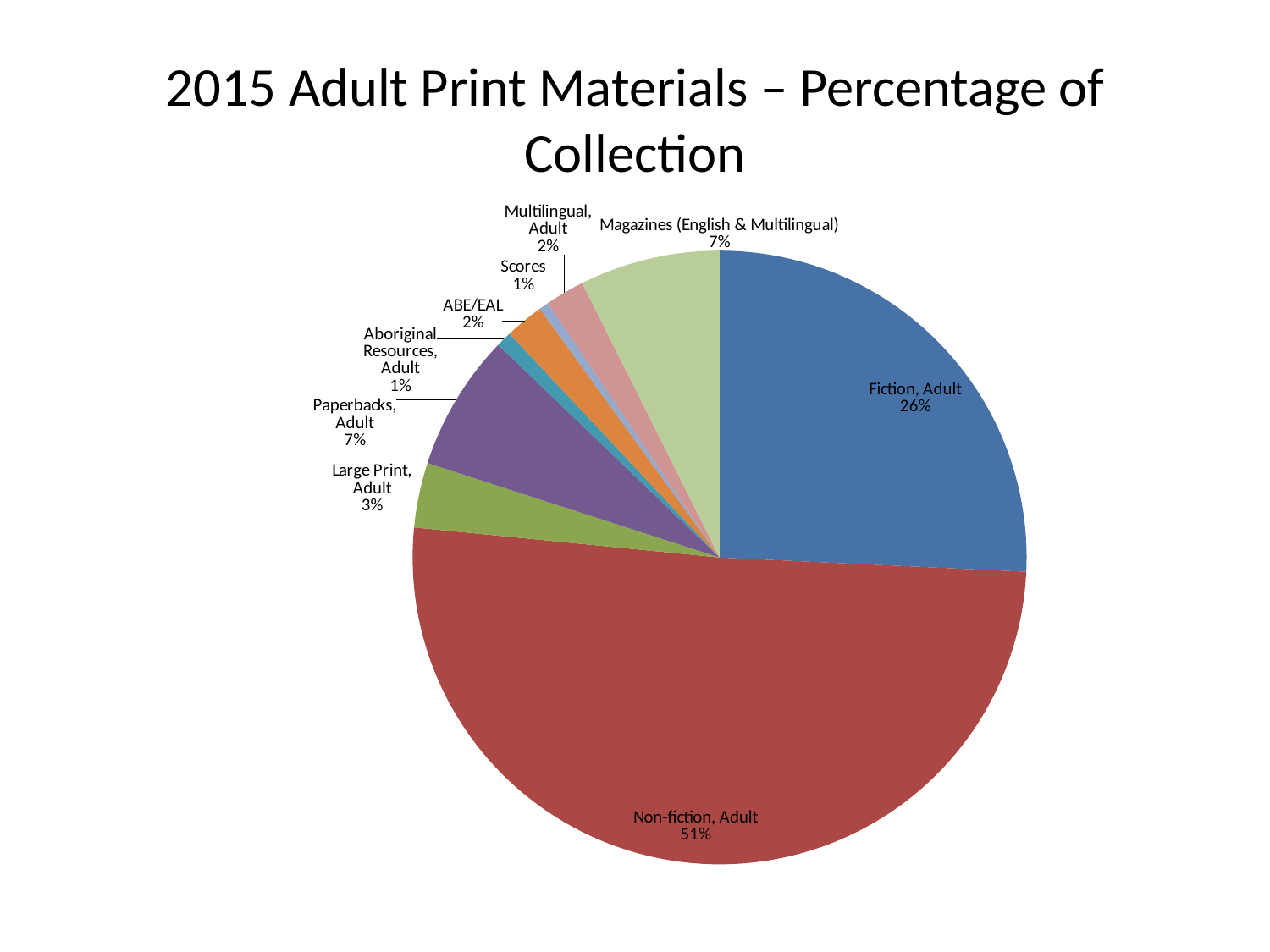
What percentage of the collection is Magazines (English & Multilingual)? 7% Which is larger, the share for Paperbacks, Adult or the share for Large Print, Adult? Paperbacks, Adult What percentage of the collection is ABE/EAL? 2% How many slices does the pie chart have? 9 Which category makes up the largest share of the collection? Non-fiction, Adult What percentage of the collection is Large Print, Adult? 3% What is the difference in percentage points between Non-fiction, Adult and Fiction, Adult? 25 What kind of chart is shown on the slide? pie chart What colour is the Non-fiction, Adult slice? red What percentage of the collection is Fiction, Adult? 26% What is the title of the chart? 2015 Adult Print Materials – Percentage of Collection What percentage of the collection is Non-fiction, Adult? 51%